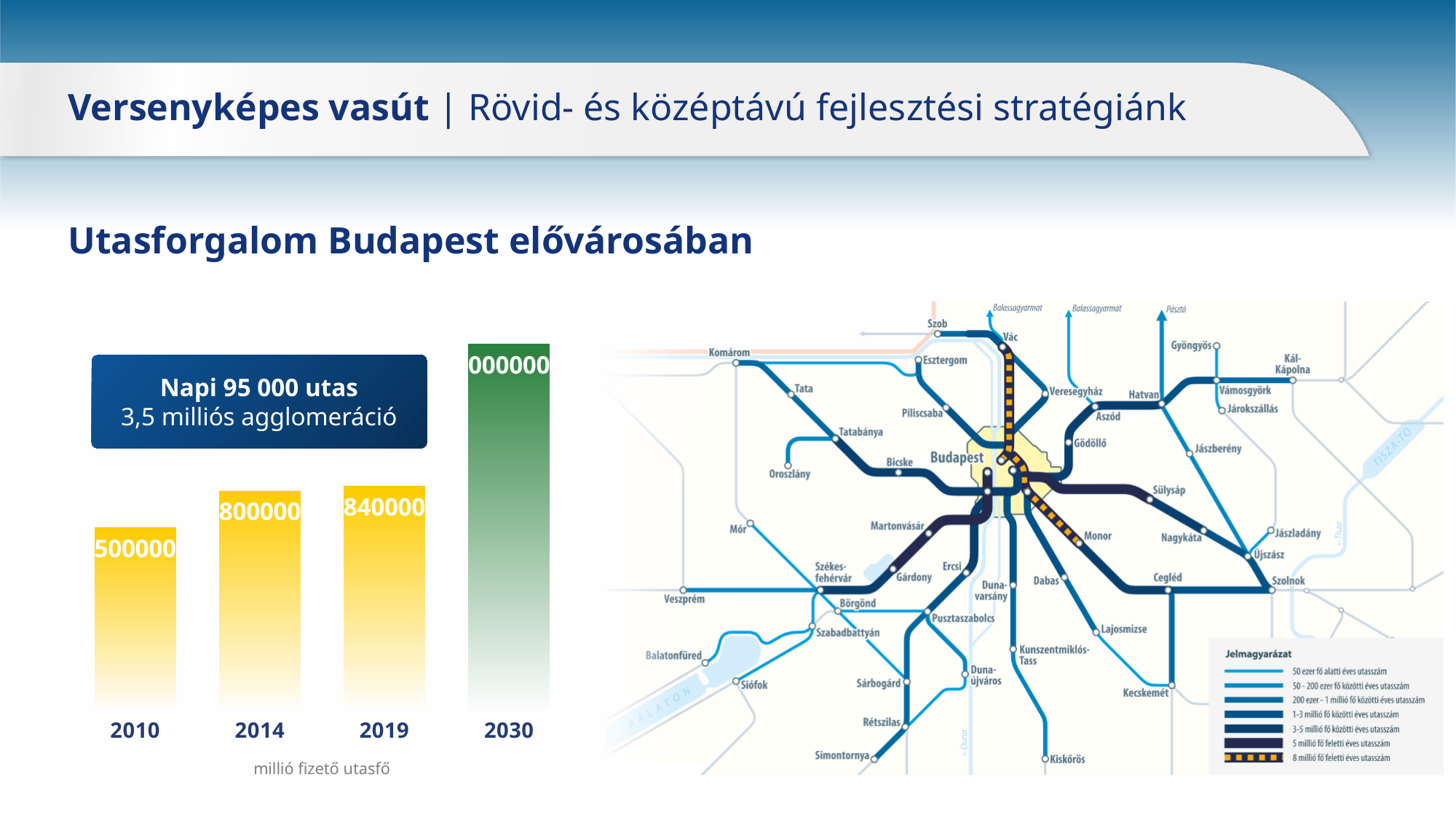
Which year has the lowest value in the bar chart? 2010 How many years are shown on the x axis of the bar chart? 4 What is the title of the bar chart? Utasforgalom Budapest elővárosában Which year has the tallest bar in the chart? 2030 Which is larger, the value for 2019 or the value for 2014? 2019 Do the values rise or fall from 2010 to 2030 in the bar chart? rise What kind of chart is shown on the left of the slide? bar chart